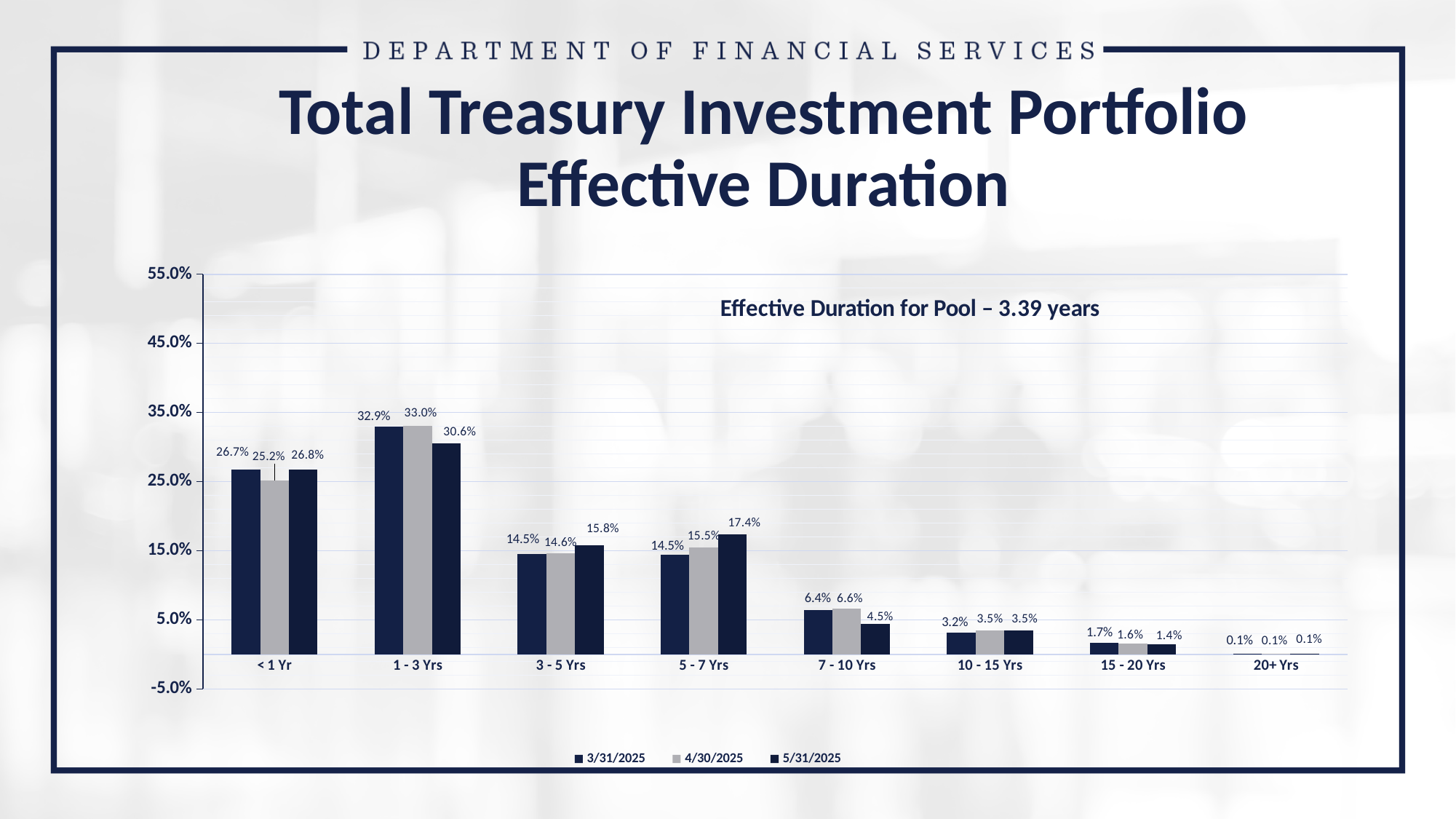
How many maturity categories are shown on the x axis? 8 What effective duration for the pool is stated on the chart? 3.39 years For the 7 - 10 Yrs category, which is larger: the 4/30/2025 value or the 5/31/2025 value? 4/30/2025 Which category has the highest value in the 4/30/2025 series? 1 - 3 Yrs How many series does the legend list? 3 What is the difference between the 5/31/2025 and 3/31/2025 values for the 5 - 7 Yrs category? 2.9% Is the 3/31/2025 value for the 1 - 3 Yrs category greater or less than 25.0%? greater What is the value for the 5 - 7 Yrs category in the 4/30/2025 series? 15.5% What kind of chart is shown on the slide? bar chart Which category has the lowest value in the 5/31/2025 series? 20+ Yrs What is the value for the 1 - 3 Yrs category in the 5/31/2025 series? 30.6% What is the value for the < 1 Yr category in the 3/31/2025 series? 26.7%